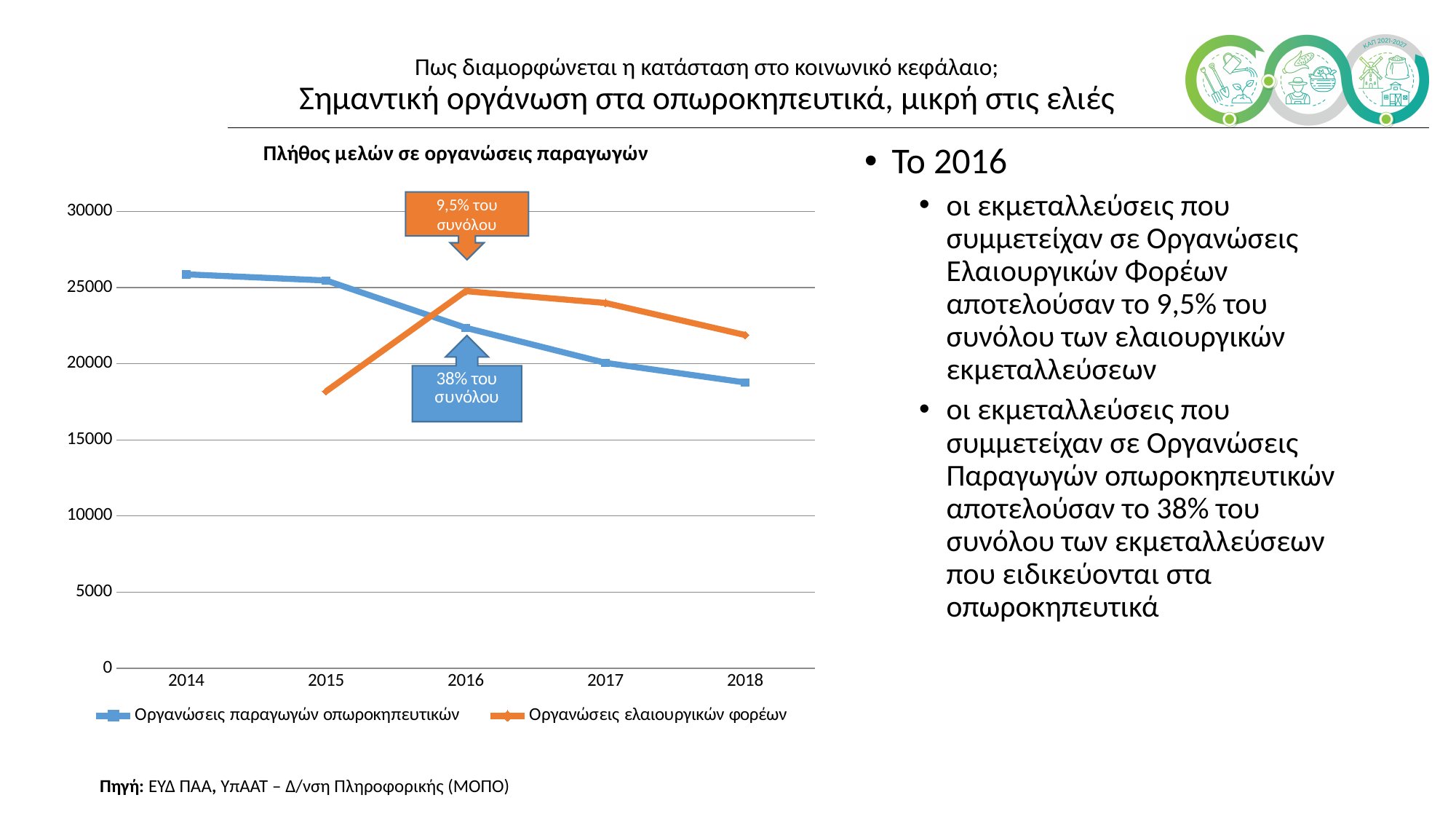
Which series is drawn in orange? Οργανώσεις ελαιουργικών φορέων In which year is the value for Οργανώσεις ελαιουργικών φορέων highest? 2016 Is the value for Οργανώσεις παραγωγών οπωροκηπευτικών in 2018 greater or less than 20000? less In which year is the value for Οργανώσεις παραγωγών οπωροκηπευτικών lowest? 2018 What is the title of the chart? Πλήθος μελών σε οργανώσεις παραγωγών Do the values for Οργανώσεις παραγωγών οπωροκηπευτικών rise or fall from 2014 to 2018? fall In 2016, which series has the larger value: Οργανώσεις παραγωγών οπωροκηπευτικών or Οργανώσεις ελαιουργικών φορέων? Οργανώσεις ελαιουργικών φορέων In which year is the value for Οργανώσεις ελαιουργικών φορέων lowest? 2015 Is the value for Οργανώσεις ελαιουργικών φορέων in 2018 greater or less than 20000? greater How many years are shown on the x axis? 5 What kind of chart is shown on the slide? line chart How many series does the legend list? 2